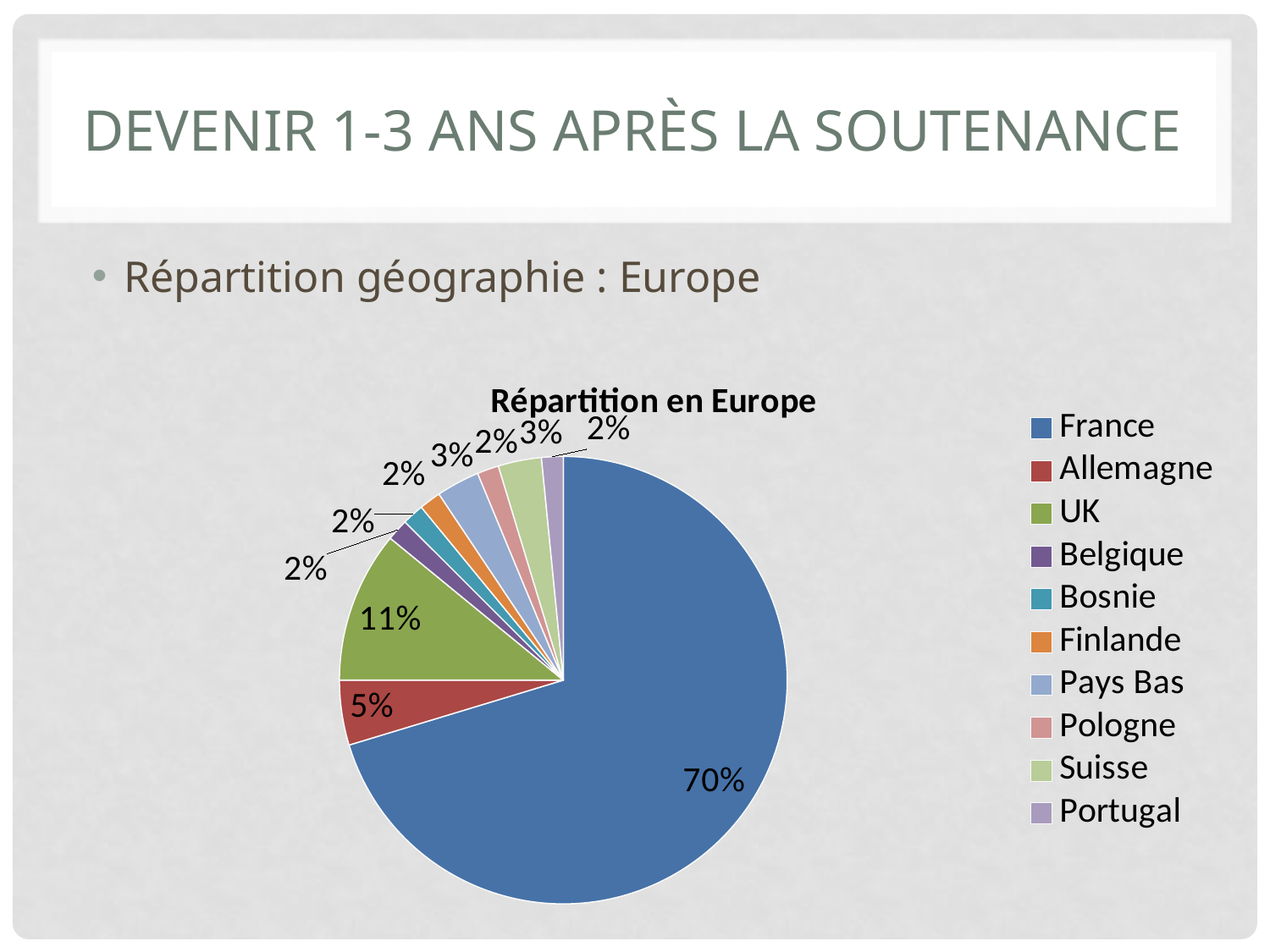
What kind of chart is shown on the slide? Pie chart What is the title of the chart? Répartition en Europe What is the value shown for Suisse? 3% What share of the pie does France hold? 70% What is the value shown for Pays Bas? 3% What is the value shown for UK? 11% Which has a larger share, UK or Allemagne? UK What is the difference between the shares of France and UK? 59 percentage points What is the value shown for Allemagne? 5% What is the difference between the shares of UK and Allemagne? 6 percentage points Which country has the largest slice of the pie? France How many countries are shown in the pie chart? 10